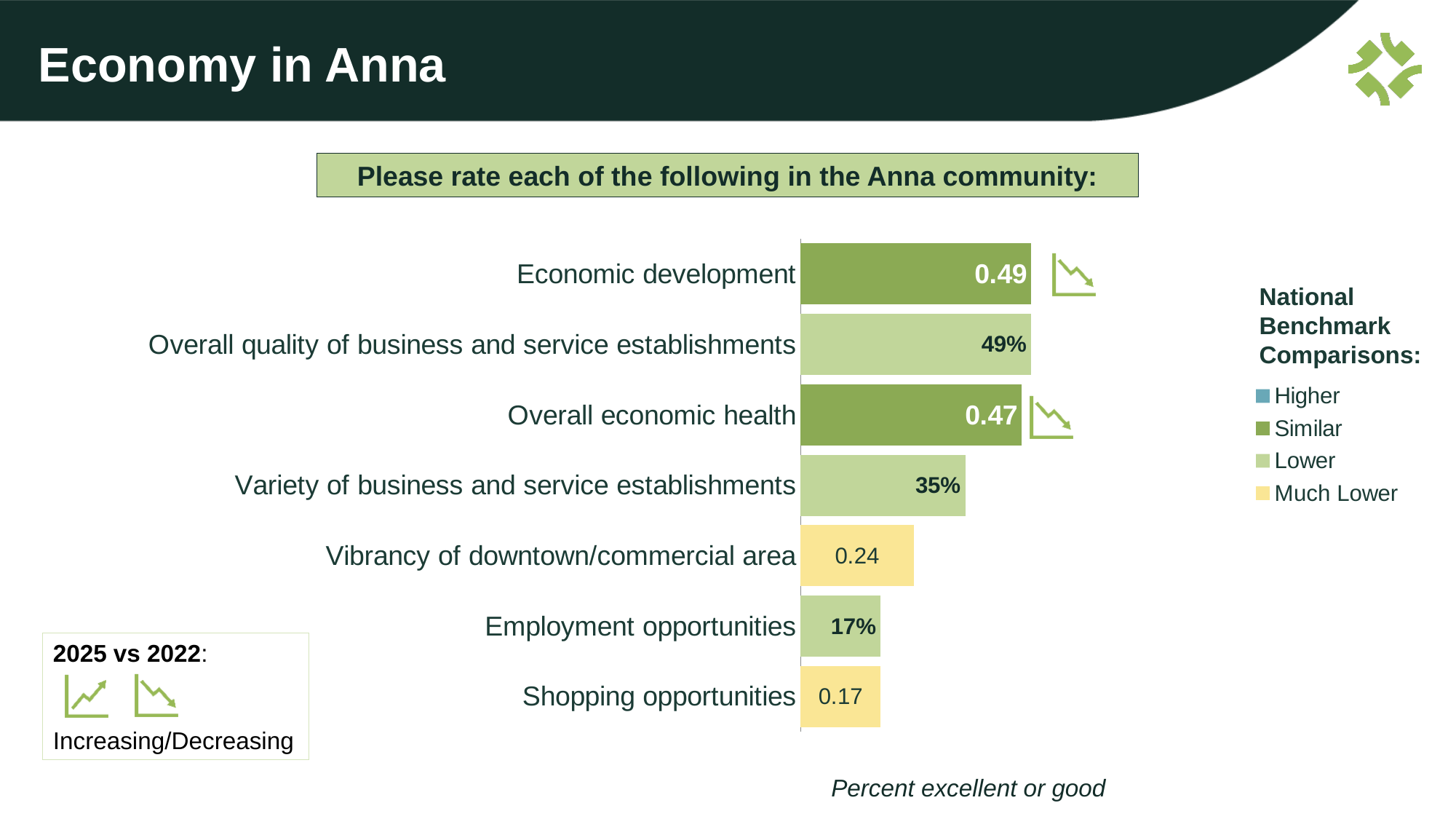
How many categories are plotted in the chart? 7 How many entries does the National Benchmark Comparisons legend list? 4 What kind of chart is shown on the slide? Bar chart What is the value shown for Vibrancy of downtown/commercial area? 0.24 What is the difference between the values for Overall quality of business and service establishments and Variety of business and service establishments? 14 percentage points What is the difference between the values for Economic development and Overall economic health? 0.02 Which has a larger value: Overall economic health or Variety of business and service establishments? Overall economic health What is the value shown for Variety of business and service establishments? 35% What is the value shown for Economic development? 0.49 What is the value shown for Overall quality of business and service establishments? 49% What is the value shown for Overall economic health? 0.47 What is the value shown for Shopping opportunities? 0.17